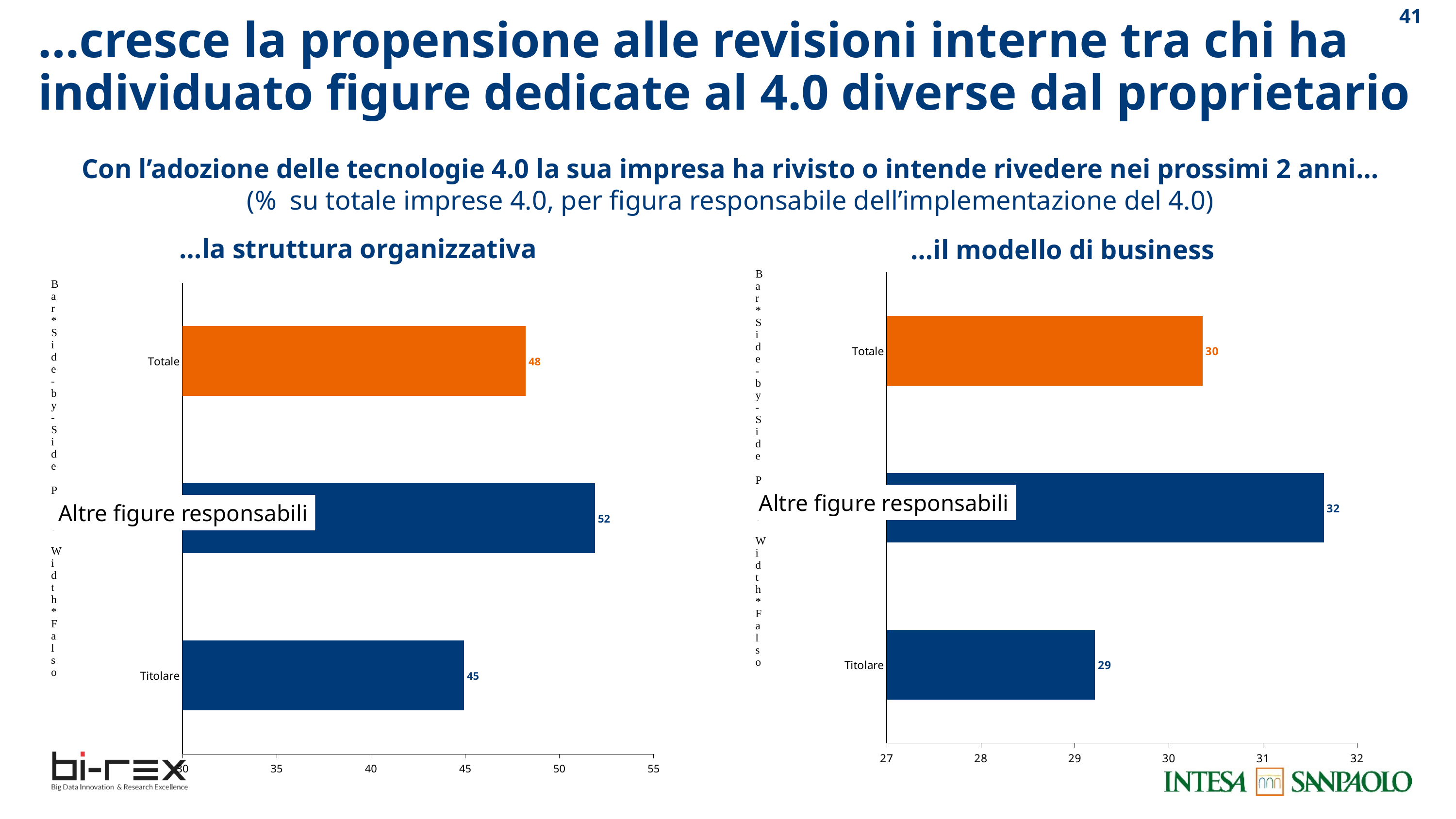
In the '...il modello di business' chart, which is larger, Altre figure responsabili or Titolare? Altre figure responsabili How many categories are shown in the '...il modello di business' chart? 3 In the '...il modello di business' chart, what is the value for Altre figure responsabili? 32 In the '...la struttura organizzativa' chart, what is the difference between Altre figure responsabili and Titolare? 7 In the '...la struttura organizzativa' chart, which category has the highest value? Altre figure responsabili In the '...la struttura organizzativa' chart, what is the value for Altre figure responsabili? 52 What type of chart is the '...la struttura organizzativa' chart? Bar chart In the '...il modello di business' chart, which category has the lowest value? Titolare In the '...il modello di business' chart, what is the value for Totale? 30 In the '...il modello di business' chart, what is the value for Titolare? 29 In the '...la struttura organizzativa' chart, what is the value for Totale? 48 In the '...la struttura organizzativa' chart, what is the value for Titolare? 45